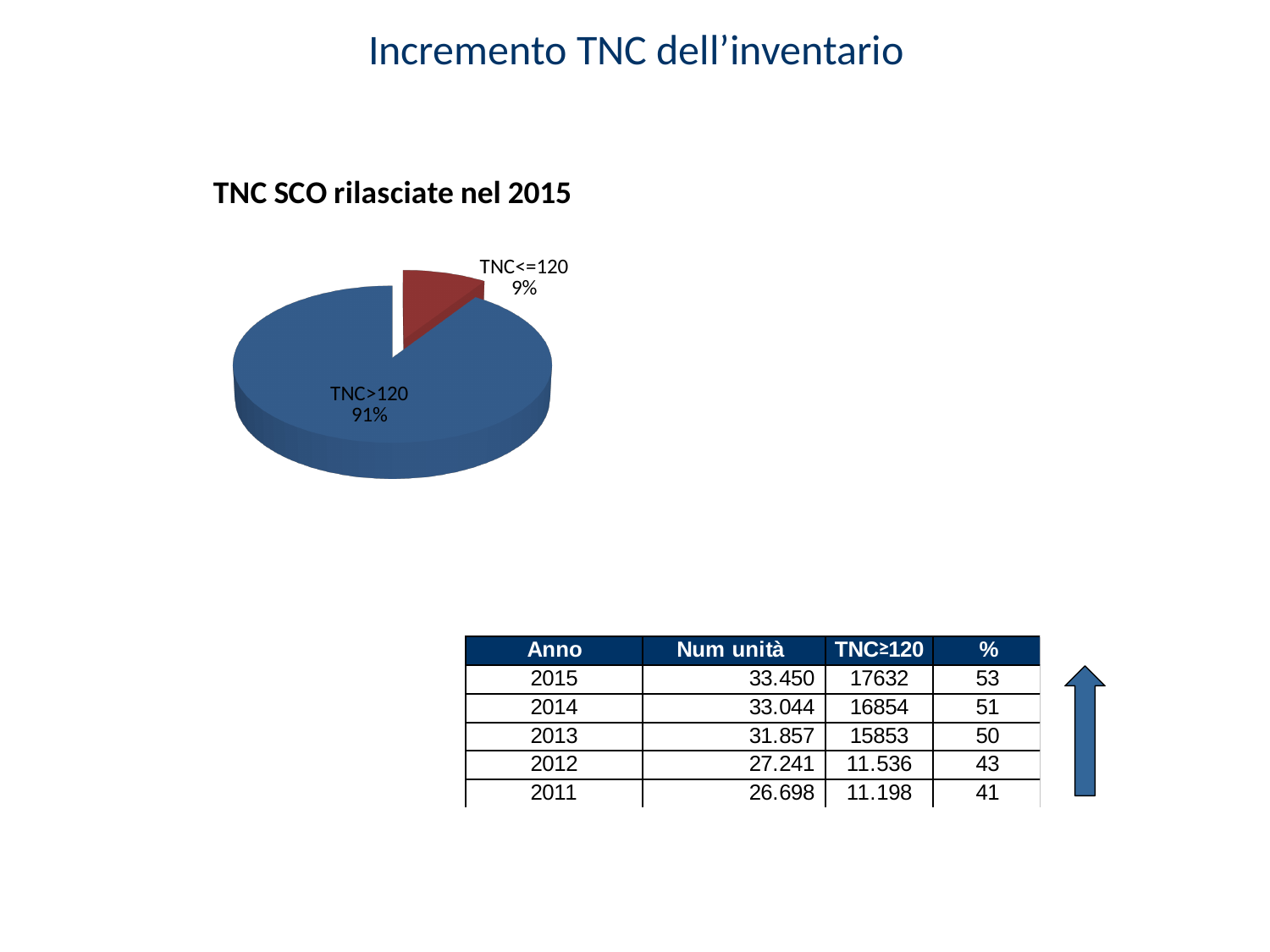
What is the title of the pie chart? TNC SCO rilasciate nel 2015 What colour is the TNC<=120 slice in the pie chart? Red What kind of chart is shown on the slide? Pie chart What share of the pie does the TNC<=120 slice represent? 9% Which slice of the pie chart is the largest? TNC>120 How many slices does the pie chart have? 2 What is the difference in percentage points between the TNC>120 slice and the TNC<=120 slice? 82 Which slice of the pie chart is the smallest? TNC<=120 Which slice is larger, TNC>120 or TNC<=120? TNC>120 What share of the pie does the TNC>120 slice represent? 91%